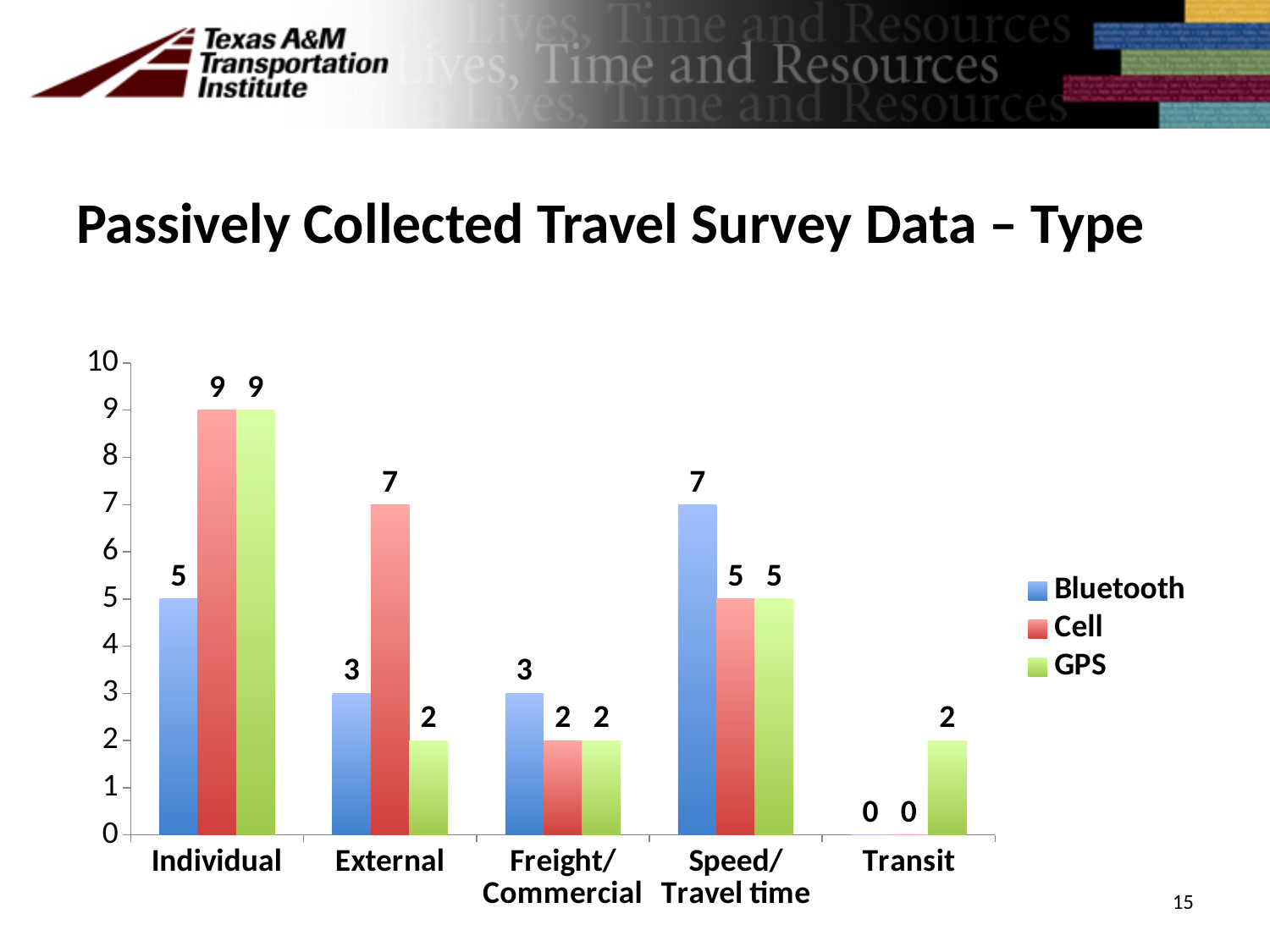
How many categories are shown on the x axis? 5 What is the Cell value for External? 7 What is the GPS value for Transit? 2 What is the difference between the Cell and GPS values for External? 5 What is the Bluetooth value for Speed/Travel time? 7 Which category has the highest Cell value? Individual Which category has the lowest Bluetooth value? Transit What kind of chart is shown on the slide? Bar chart Which is larger, the Bluetooth value for Speed/Travel time or the Bluetooth value for Individual? Speed/Travel time How many series does the legend list? 3 What is the Bluetooth value for Individual? 5 What is the title of the slide? Passively Collected Travel Survey Data – Type